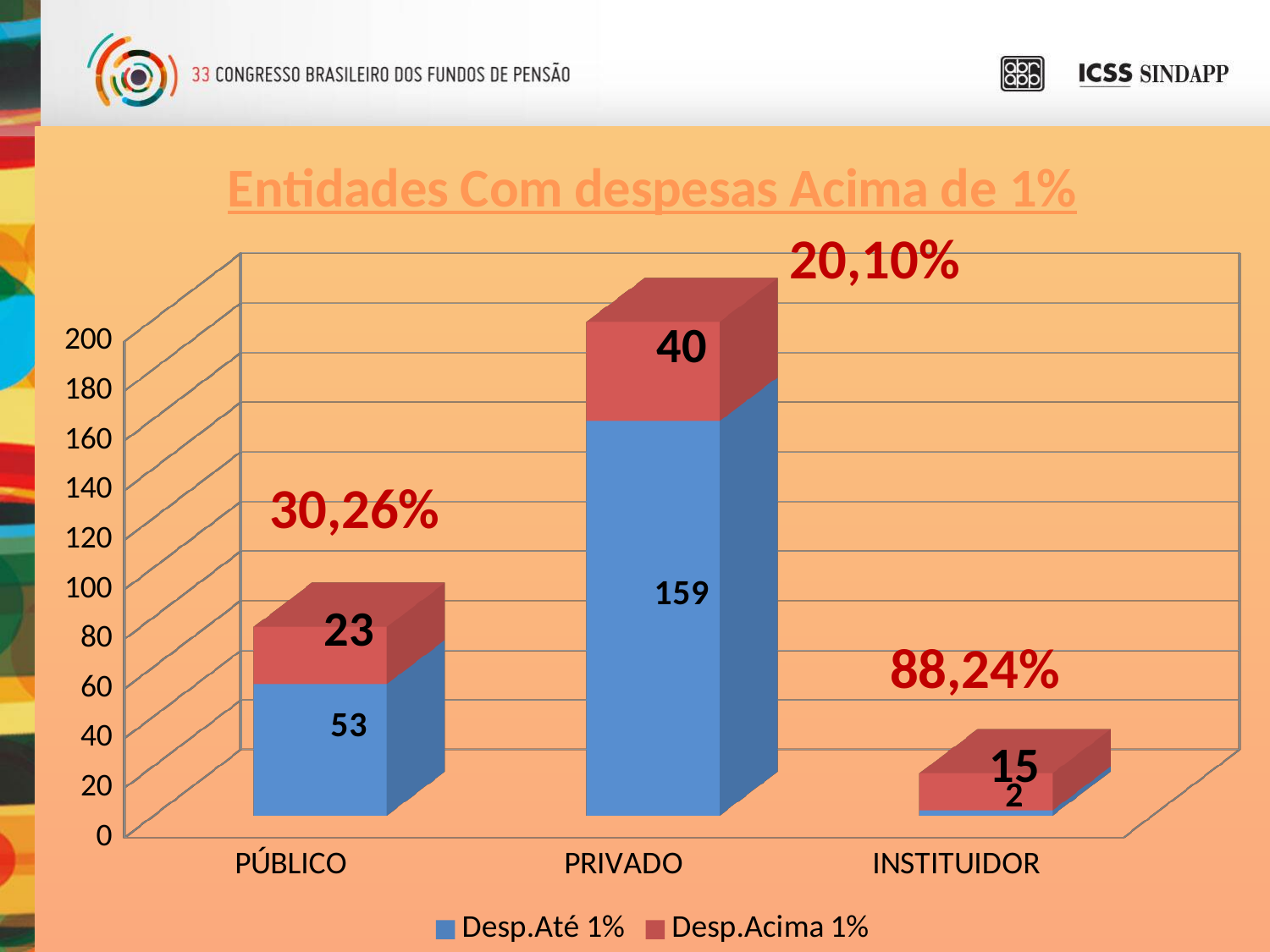
What is the value of Desp.Até 1% for PRIVADO? 159 What is the value of Desp.Até 1% for INSTITUIDOR? 2 How many categories are shown on the x axis? 3 Which category has the highest value for Desp.Acima 1%? PRIVADO How many series does the legend list? 2 What percentage is annotated above the INSTITUIDOR bar? 88,24% What is the difference between the Desp.Até 1% values for PRIVADO and PÚBLICO? 106 Which category has the lowest value for Desp.Até 1%? INSTITUIDOR Which is larger for INSTITUIDOR: Desp.Até 1% or Desp.Acima 1%? Desp.Acima 1% What is the total of the stacked bar for PÚBLICO? 76 What is the value of Desp.Acima 1% for PÚBLICO? 23 What is the total of the stacked bar for PRIVADO? 199